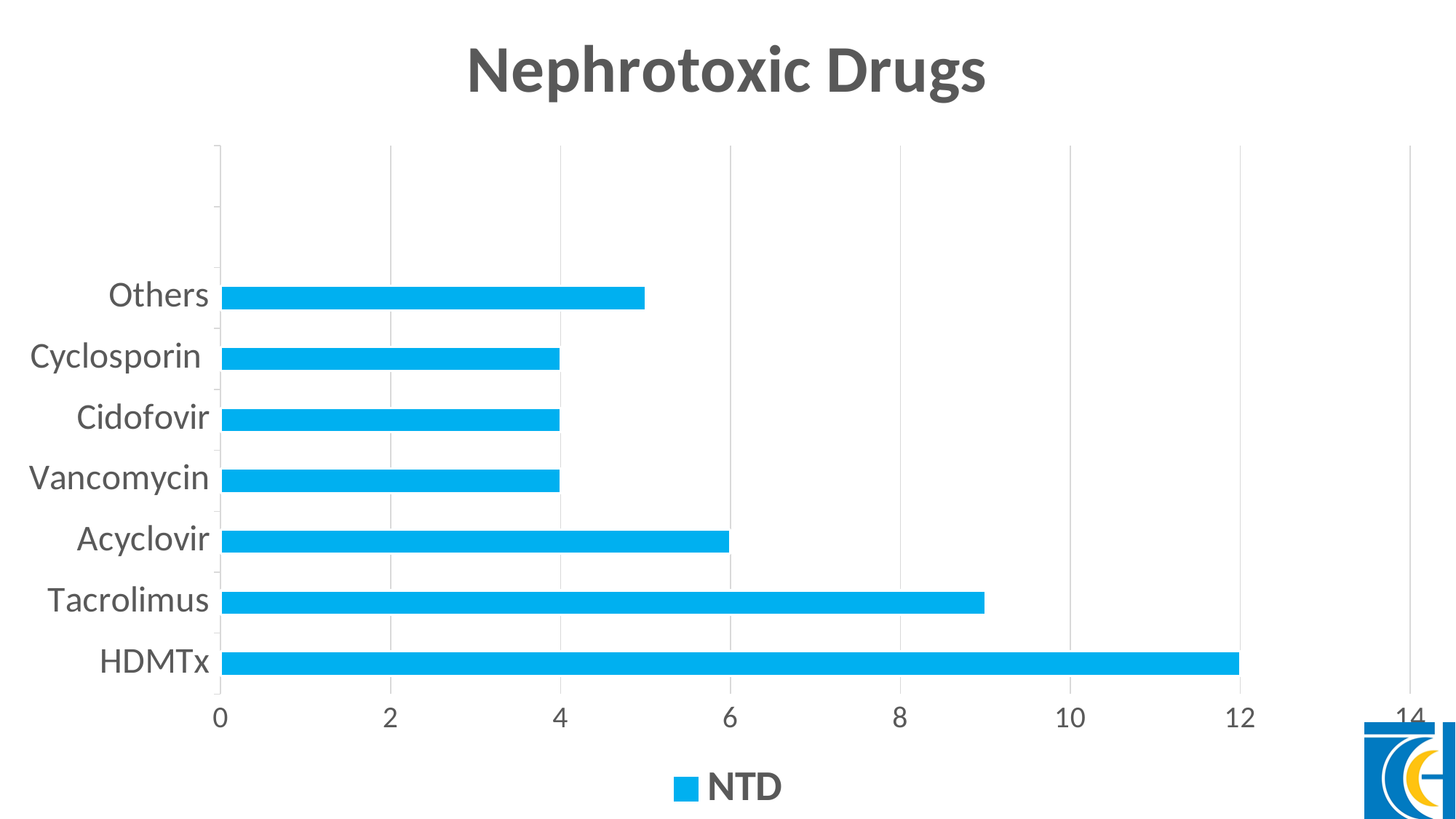
What is the title of the chart? Nephrotoxic Drugs What type of chart is shown on the slide? bar chart How many drug categories are plotted in the chart? 7 Which has a larger value, Tacrolimus or Acyclovir? Tacrolimus What is the name of the series shown in the legend? NTD Is the value for Tacrolimus greater or less than 8? greater What is the value for Acyclovir? 6 What is the value for Vancomycin? 4 What is the value for HDMTx? 12 How many series does the legend list? 1 What is the difference between the values for HDMTx and Acyclovir? 6 Which drug has the highest value? HDMTx